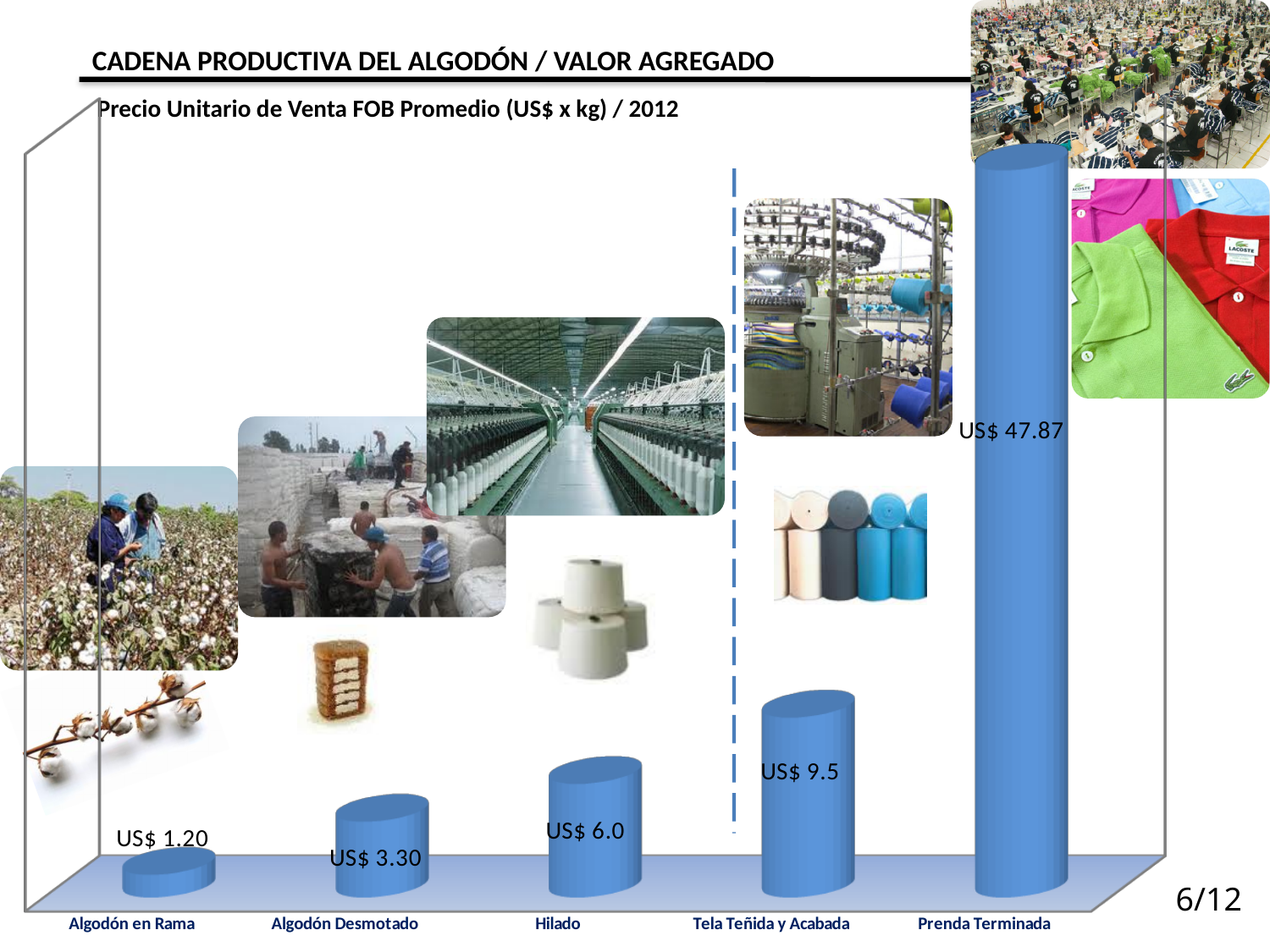
Which is larger, the value for Hilado or the value for Tela Teñida y Acabada? Tela Teñida y Acabada What is the value for Algodón Desmotado? US$ 3.30 What is the value for Tela Teñida y Acabada? US$ 9.5 What is the value for Hilado? US$ 6.0 What is the value for Prenda Terminada? US$ 47.87 What is the difference between the values for Algodón Desmotado and Algodón en Rama? US$ 2.10 Which category has the lowest value? Algodón en Rama How many categories are shown in the chart? 5 Do the values rise or fall from left to right along the x axis? rise What is the difference between the values for Prenda Terminada and Tela Teñida y Acabada? US$ 38.37 Which category has the highest value? Prenda Terminada What is the value for Algodón en Rama? US$ 1.20